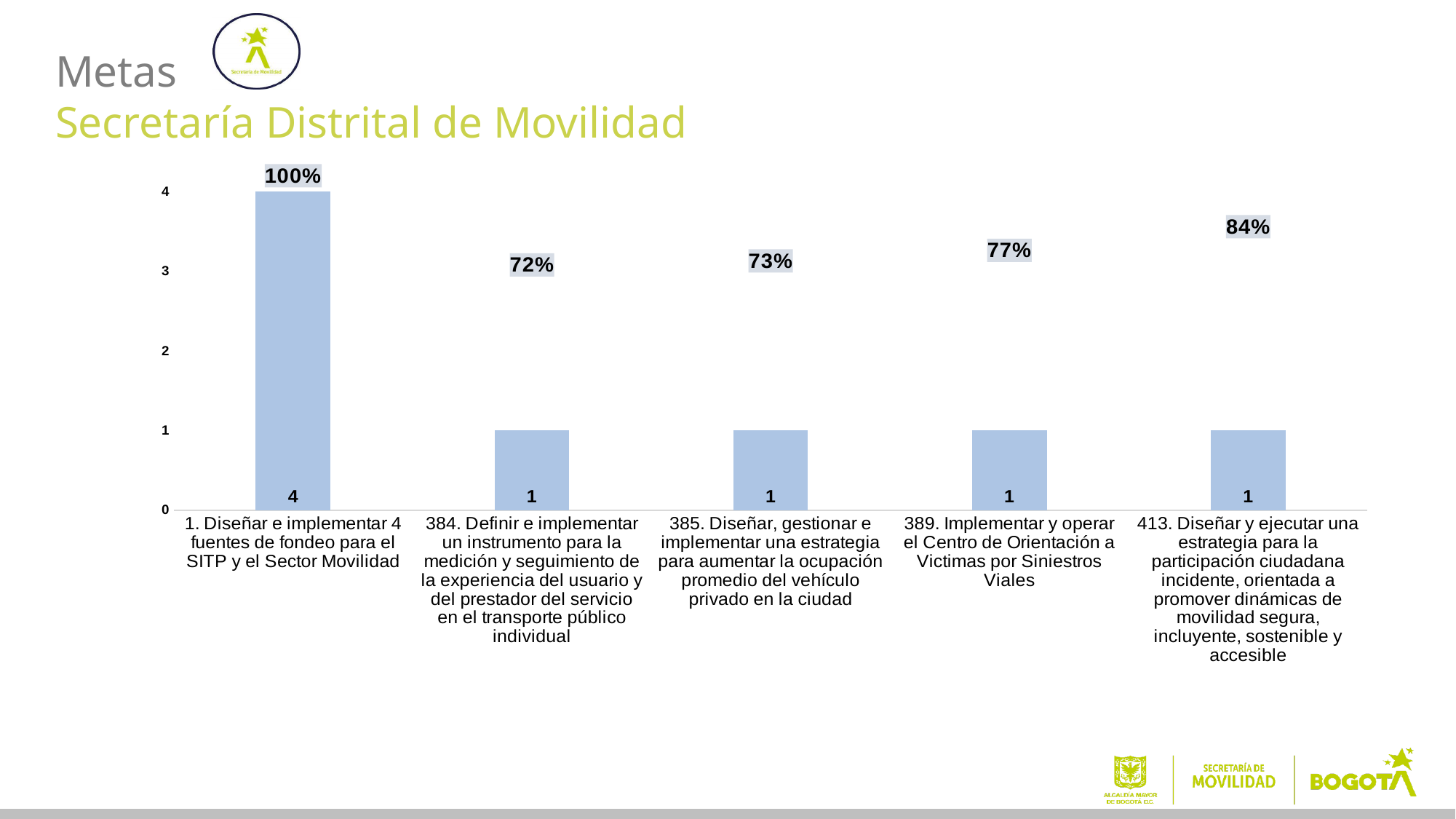
Is the bar for meta 1 greater or less than 3 on the vertical axis? greater How many metas (categories) are plotted in the chart? 5 Which has the higher percentage label: meta 385 or meta 389? 389 (77%) What percentage is shown above the bar for meta 389 (Implementar y operar el Centro de Orientación a Victimas por Siniestros Viales)? 77% What is the difference between the percentage for meta 1 (100%) and the percentage for meta 384 (72%)? 28% Which meta has the lowest percentage label? 384. Definir e implementar un instrumento para la medición y seguimiento de la experiencia del usuario (72%) What percentage is shown for meta 413 (Diseñar y ejecutar una estrategia para la participación ciudadana incidente)? 84% What is the value of the bar for meta 385 (Diseñar, gestionar e implementar una estrategia para aumentar la ocupación promedio del vehículo privado)? 1 Which meta has the tallest bar in the chart? 1. Diseñar e implementar 4 fuentes de fondeo para el SITP y el Sector Movilidad What colour are the bars in the chart? Light blue What kind of chart is shown on the slide? Bar chart What is the value of the bar for meta 1 (Diseñar e implementar 4 fuentes de fondeo para el SITP y el Sector Movilidad)? 4